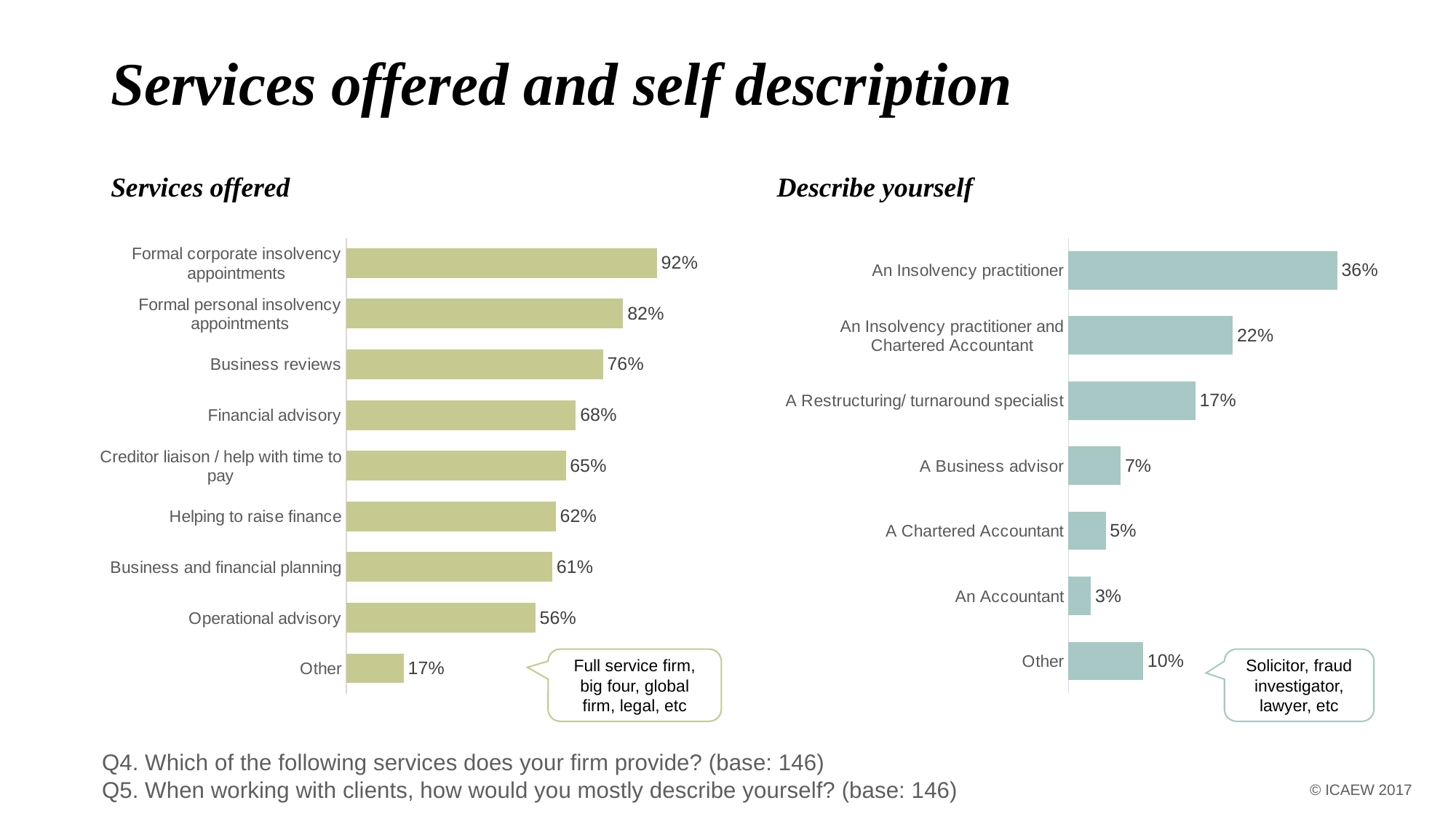
In the 'Describe yourself' chart, what is the value for A Restructuring/ turnaround specialist? 17% In the 'Services offered' chart, which is larger: Financial advisory or Operational advisory? Financial advisory In the 'Describe yourself' chart, which category has the lowest value? An Accountant In the 'Services offered' chart, what is the value for Business reviews? 76% In the 'Describe yourself' chart, how many categories are shown? 7 What type of chart is the 'Describe yourself' chart? Bar chart In the 'Services offered' chart, what is the difference between Formal corporate insolvency appointments and Formal personal insolvency appointments? 10% In the 'Describe yourself' chart, which category has the highest value? An Insolvency practitioner In the 'Describe yourself' chart, what is the difference between An Insolvency practitioner and An Insolvency practitioner and Chartered Accountant? 14% In the 'Services offered' chart, how many categories are shown? 9 In the 'Services offered' chart, which category has the lowest value? Other In the 'Services offered' chart, which category has the highest value? Formal corporate insolvency appointments